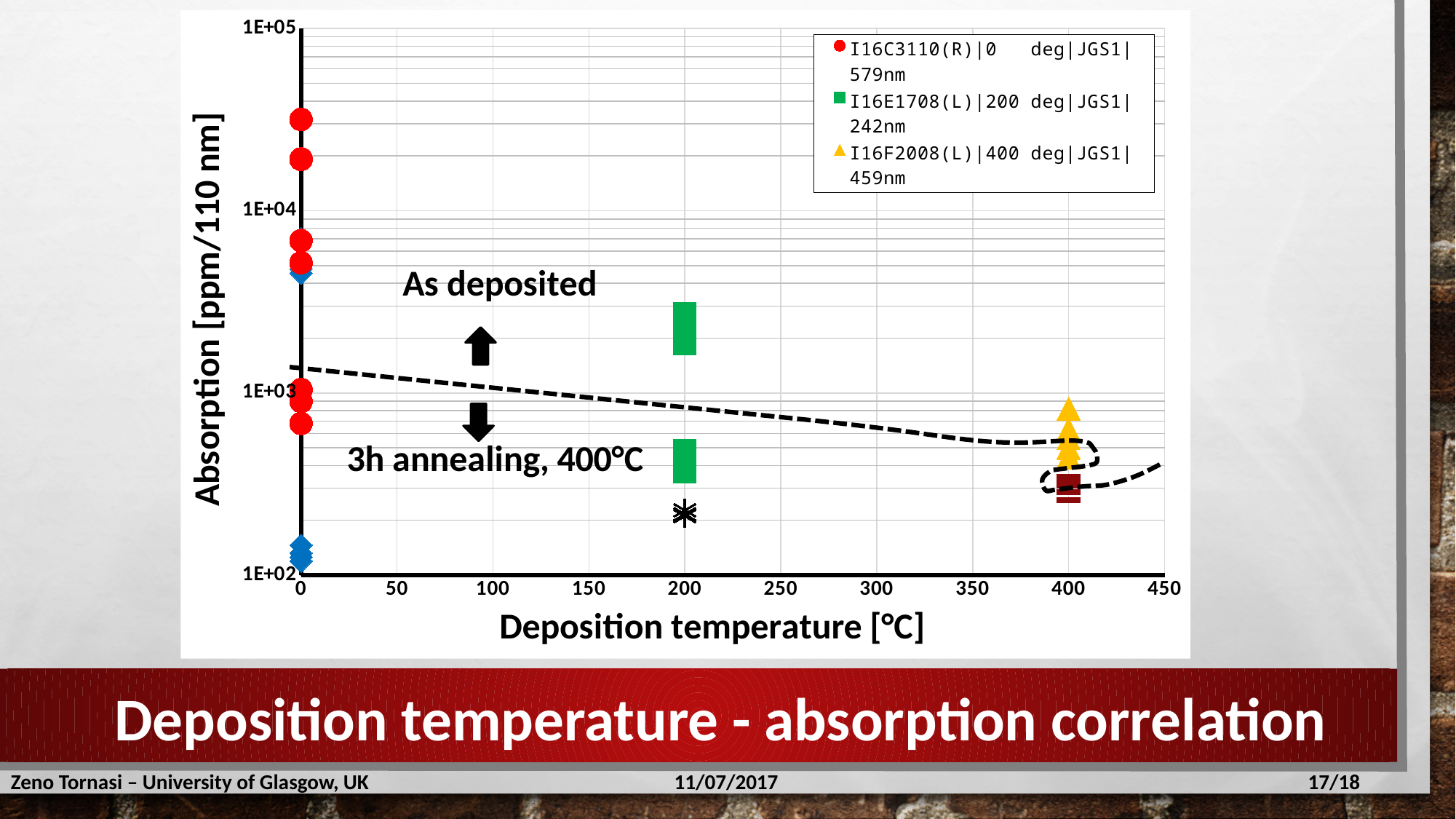
Which has higher as-deposited absorption: the green squares at 200 °C or the yellow triangles at 400 °C? green squares at 200 °C What is the title of the x axis? Deposition temperature [°C] What is the title of the y axis? Absorption [ppm/110 nm] Are the blue diamond values near the bottom of the chart at 0 °C greater or less than 1E+03? less What is the maximum value shown on the x axis? 450 Which deposition temperature shows the highest as-deposited absorption values? 0 Are the as-deposited green square values at 200 °C greater or less than 1E+03? greater Are the yellow triangle values at 400 °C greater or less than 1E+03? less How many series does the legend list? 3 Does the dashed trend line rise or fall as deposition temperature increases? fall What kind of chart is shown on the slide? scatter chart